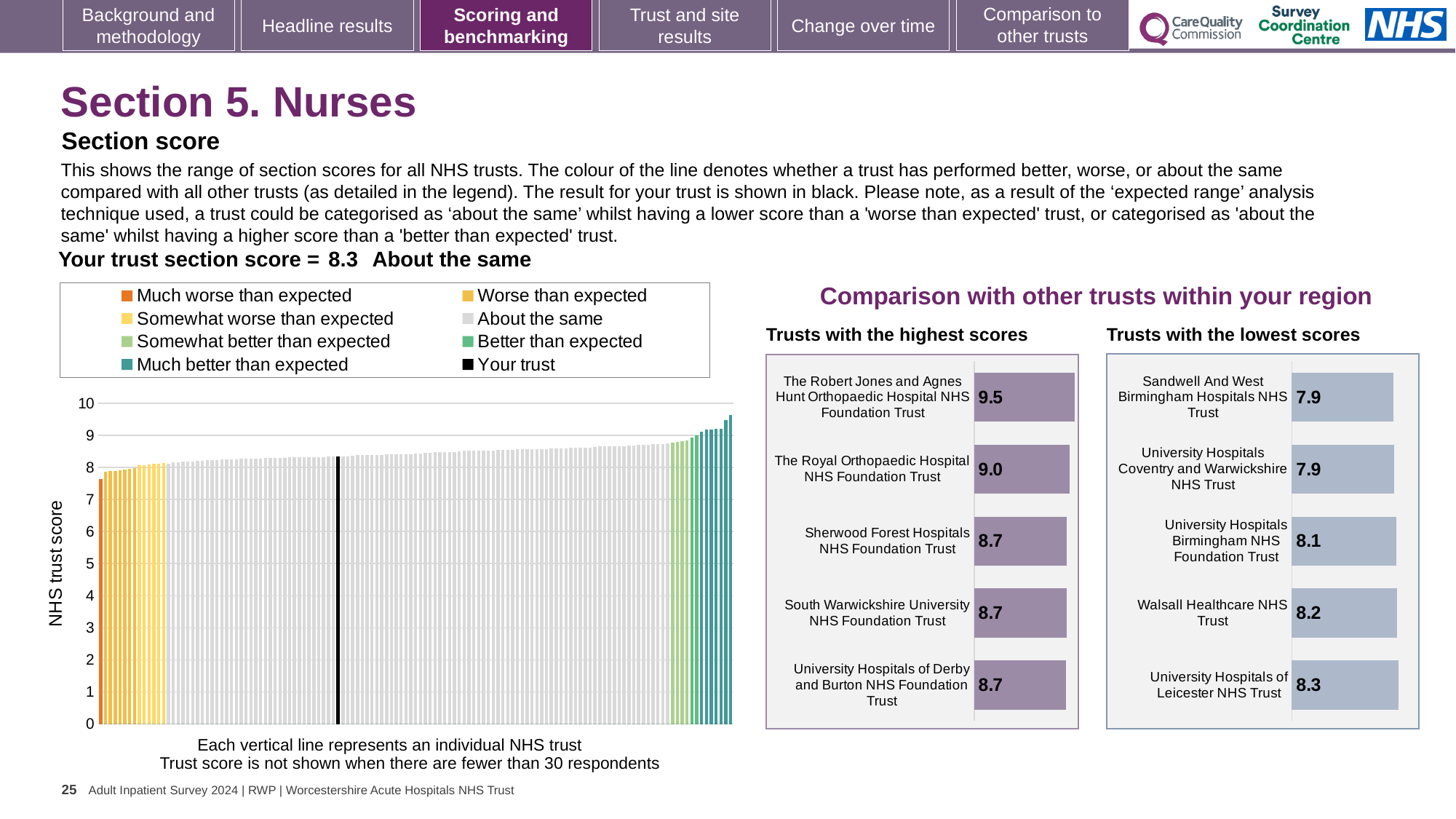
In the 'Trusts with the lowest scores' chart, what is the difference between the scores of University Hospitals of Leicester NHS Trust and Sandwell And West Birmingham Hospitals NHS Trust? 0.4 How many trusts are shown in the 'Trusts with the highest scores' chart? 5 In the large 'NHS trust score' chart on the left, do the values rise or fall from left to right? Rise In the 'Trusts with the highest scores' chart, which trust has the highest score? The Robert Jones and Agnes Hunt Orthopaedic Hospital NHS Foundation Trust In the 'Trusts with the lowest scores' chart, which trust has the highest score? University Hospitals of Leicester NHS Trust In the 'Trusts with the highest scores' chart, what is the difference between the scores of The Robert Jones and Agnes Hunt Orthopaedic Hospital NHS Foundation Trust and The Royal Orthopaedic Hospital NHS Foundation Trust? 0.5 In the 'Trusts with the lowest scores' chart, what is the score for Walsall Healthcare NHS Trust? 8.2 How many entries does the legend of the large 'NHS trust score' chart on the left list? 8 In the 'Trusts with the highest scores' chart, what is the score for The Robert Jones and Agnes Hunt Orthopaedic Hospital NHS Foundation Trust? 9.5 What kind of chart is the large 'NHS trust score' chart on the left of the slide? Bar chart In the 'Trusts with the lowest scores' chart, which has the larger score: University Hospitals Birmingham NHS Foundation Trust or Walsall Healthcare NHS Trust? Walsall Healthcare NHS Trust In the large 'NHS trust score' chart on the left, is the value of the tallest bar greater or less than 9? greater